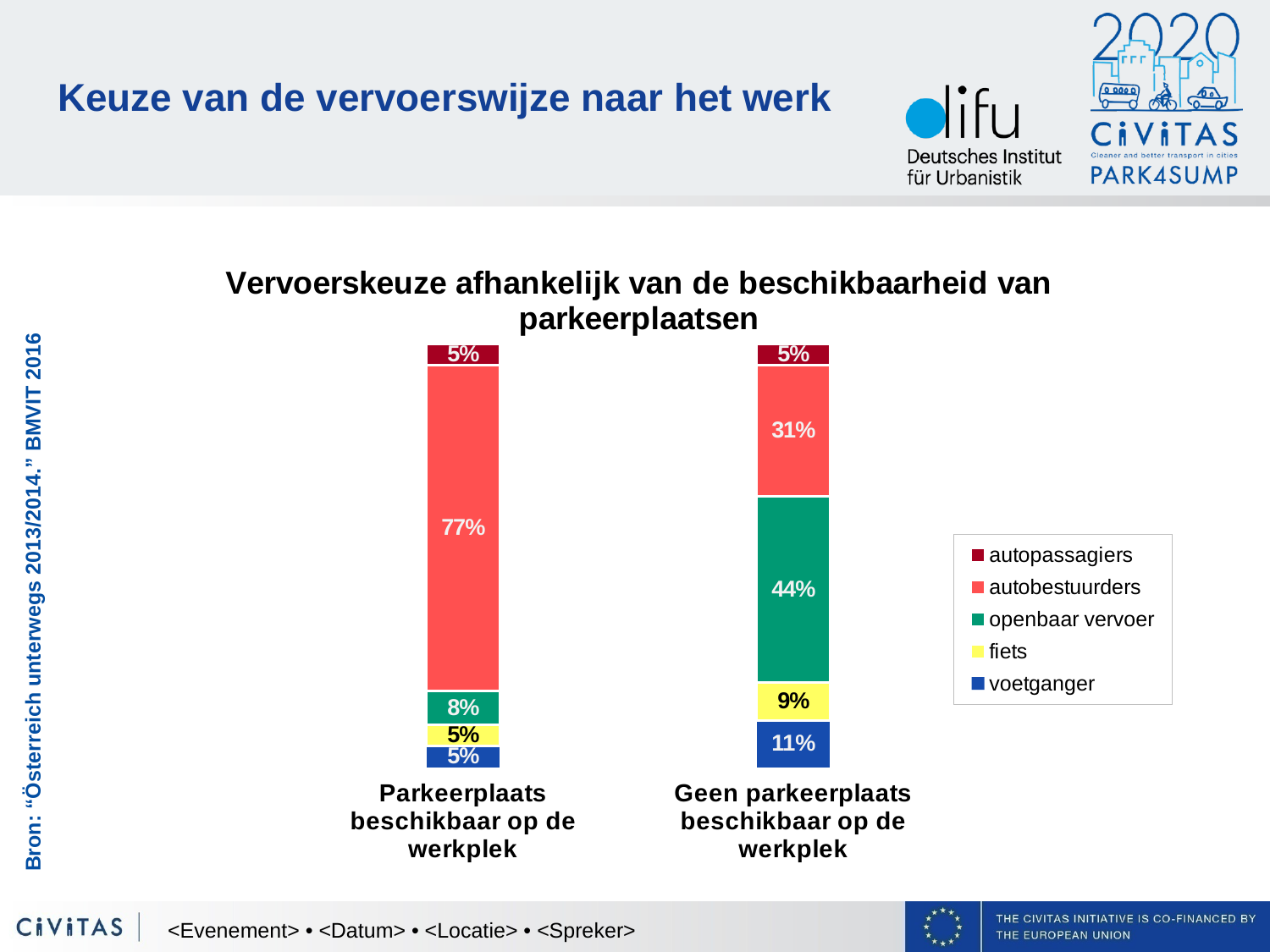
How many categories (bars) are shown on the x axis? 2 What is the value for openbaar vervoer in the 'Geen parkeerplaats beschikbaar op de werkplek' bar? 44% What is the total of the 'Geen parkeerplaats beschikbaar op de werkplek' stacked bar? 100% What kind of chart is shown on the slide? Stacked bar chart What is the difference between the autobestuurders values of the 'Parkeerplaats beschikbaar op de werkplek' bar and the 'Geen parkeerplaats beschikbaar op de werkplek' bar? 46% What is the value for fiets in the 'Parkeerplaats beschikbaar op de werkplek' bar? 5% How many series does the legend list? 5 What is the value for autobestuurders in the 'Parkeerplaats beschikbaar op de werkplek' bar? 77% What is the title of the chart? Vervoerskeuze afhankelijk van de beschikbaarheid van parkeerplaatsen Which series has the largest share in the 'Geen parkeerplaats beschikbaar op de werkplek' bar? openbaar vervoer Which bar has the larger value for openbaar vervoer: 'Parkeerplaats beschikbaar op de werkplek' or 'Geen parkeerplaats beschikbaar op de werkplek'? Geen parkeerplaats beschikbaar op de werkplek What is the value for voetganger in the 'Geen parkeerplaats beschikbaar op de werkplek' bar? 11%